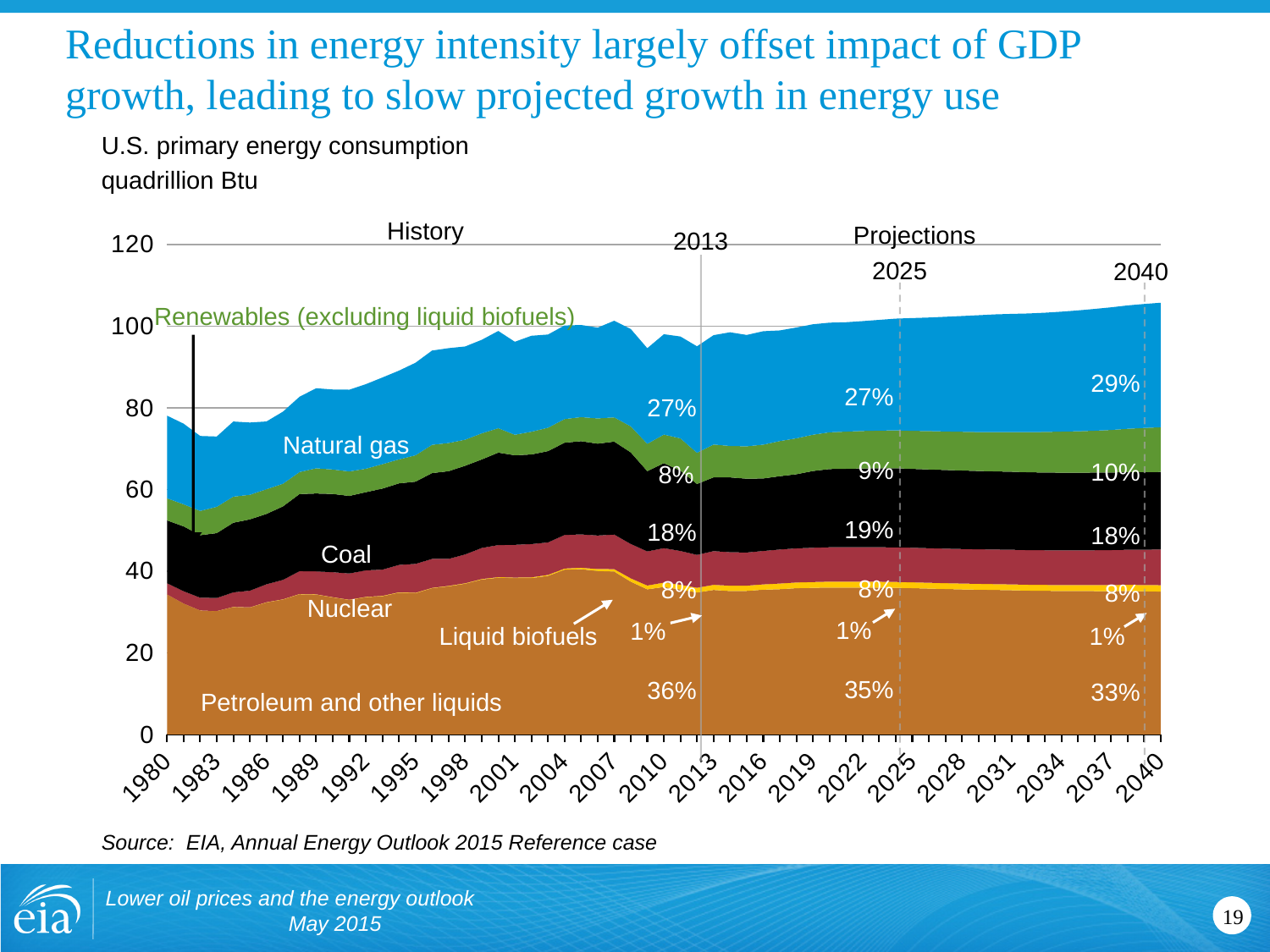
What is the share of coal in 2025? 19% What share of U.S. primary energy consumption does natural gas account for in 2040? 29% How many fuel categories are stacked in the chart? 6 What is the share of renewables (excluding liquid biofuels) in 2040? 10% By how many percentage points does the share of petroleum and other liquids fall from 2013 to 2040? 3 percentage points What share of U.S. primary energy consumption does petroleum and other liquids account for in 2013? 36% Which fuel has the largest share of U.S. primary energy consumption in 2013? Petroleum and other liquids Is total U.S. primary energy consumption in 2040 greater or less than 100 quadrillion Btu? greater In 2040, which has the larger share: natural gas or petroleum and other liquids? Petroleum and other liquids What is the share of liquid biofuels in 2025? 1% In what unit is U.S. primary energy consumption measured in the chart? quadrillion Btu What kind of chart is shown on the slide? Stacked area chart